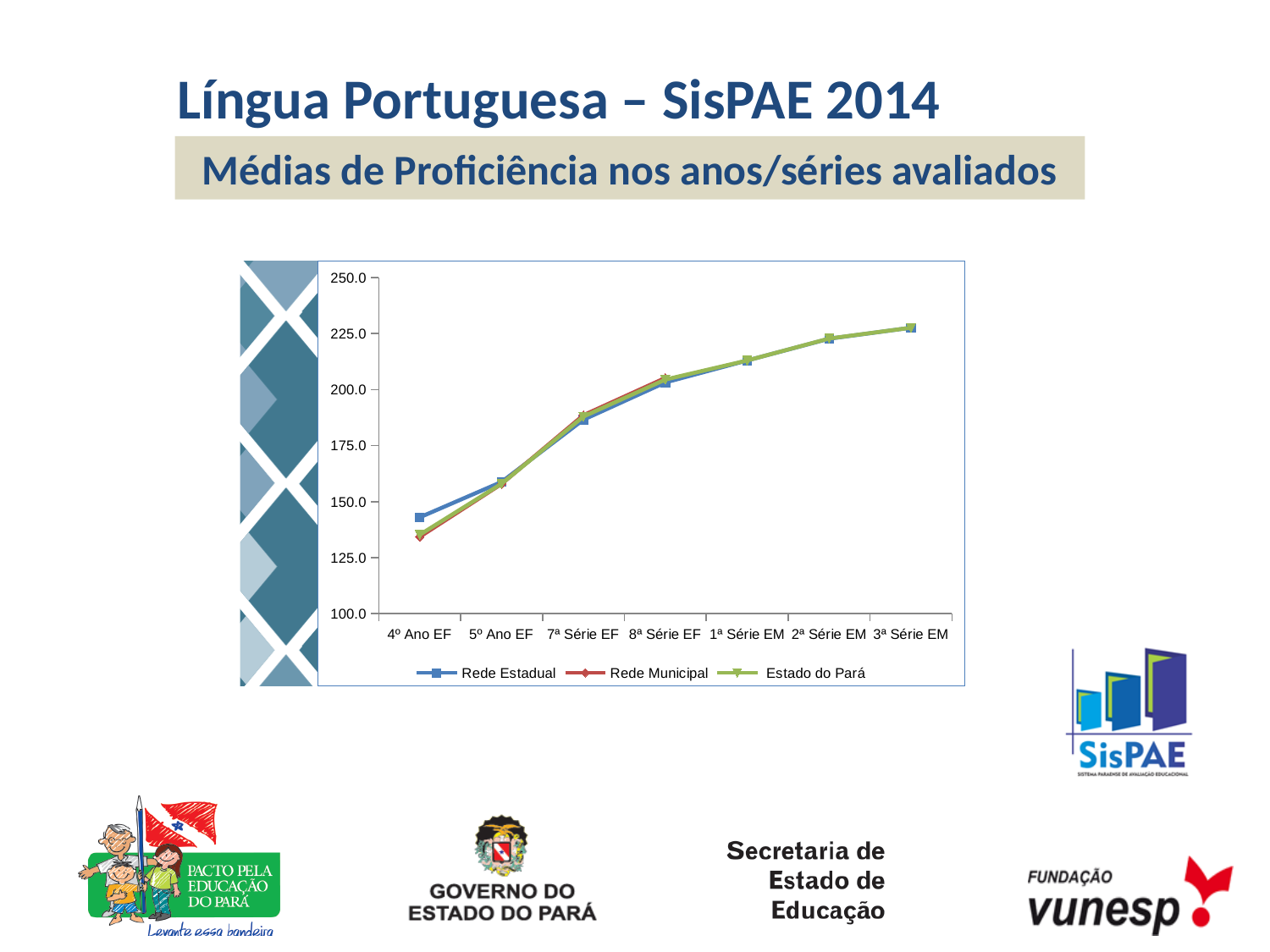
How many series does the legend list? 3 Do the values for Rede Estadual rise or fall from 4º Ano EF to 3ª Série EM? rise What kind of chart is shown on the slide? line chart Which category has the highest value for Estado do Pará? 3ª Série EM Which series are listed in the legend? Rede Estadual, Rede Municipal, Estado do Pará What is the subtitle shown above the chart? Médias de Proficiência nos anos/séries avaliados Which category has the lowest value for Rede Municipal? 4º Ano EF Is the value for Rede Estadual at 4º Ano EF greater or less than 150? less Is the value for Estado do Pará at 1ª Série EM greater or less than 200? greater At 4º Ano EF, which is larger: Rede Estadual or Rede Municipal? Rede Estadual How many categories are shown on the x axis? 7 Is the value for Rede Municipal at 7ª Série EF greater or less than 175? greater